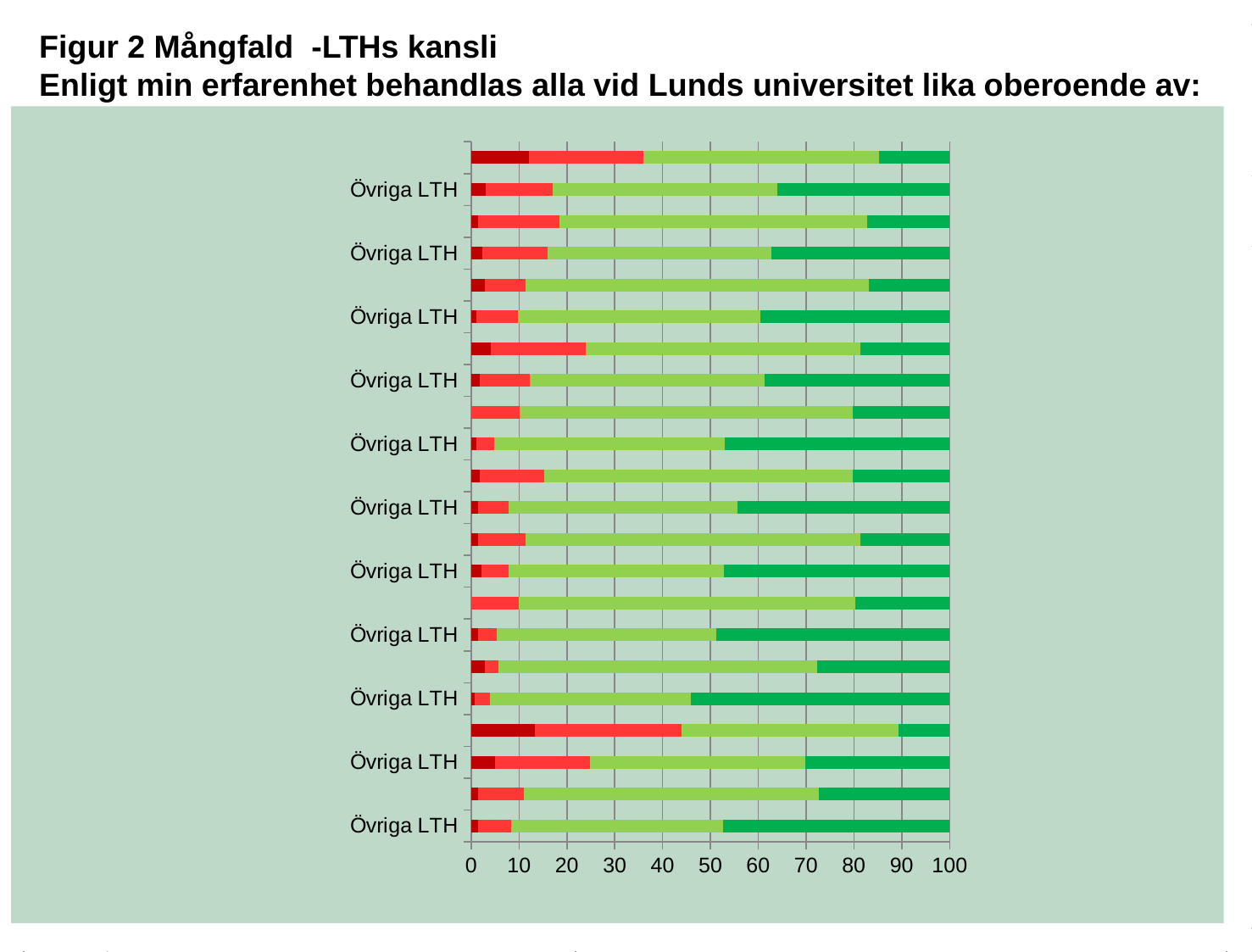
In the bottom bar of the chart (labelled Övriga LTH), does the combined red portion end at a value greater or less than 10? less Which bar in the chart has the largest combined red portion: the topmost bar or the bottom bar? The topmost bar How many bars in the chart are labelled "Övriga LTH"? 11 In the topmost bar of the chart, does the combined red portion (dark red plus red) end at a value greater or less than 30? greater What kind of chart is shown on the slide? Stacked bar chart In the topmost bar of the chart, does the light green segment end at a value greater or less than 80? greater How many bars are plotted in the chart? 22 How many differently coloured segments does each bar in the chart contain? 4 Are the bars in the chart drawn horizontally or vertically? Horizontally What is the highest value shown on the horizontal axis of the chart? 100 Is the combined red portion of the topmost bar larger or smaller than the combined red portion of the bottom bar? larger